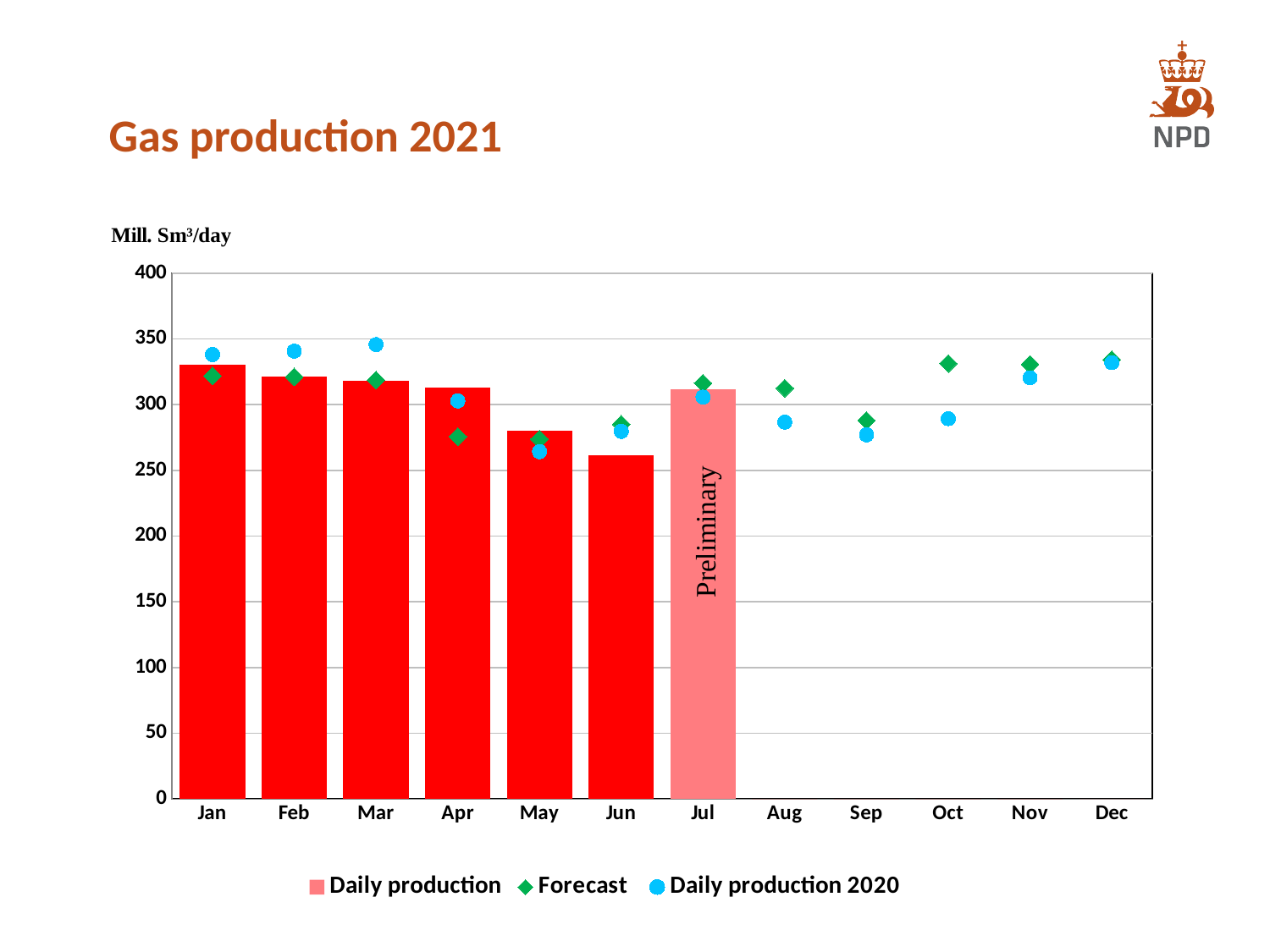
How many months are shown on the x axis? 12 Is the Daily production 2020 value for Mar greater or less than 300? greater How many series does the legend list? 3 What kind of chart is shown on the slide? bar chart with point markers (combination chart) Which is larger, the Daily production bar for Jan or for Jun? Jan Is the Daily production value for Jun greater or less than 300? less How many months have a Daily production bar? 7 Which month has the highest Daily production bar? Jan Do the Daily production bars rise or fall from Jan to Jun? fall Which month has the lowest Daily production bar? Jun Which is larger, the Forecast value for Dec or for Sep? Dec Is the Daily production value for Jan greater or less than 300? greater